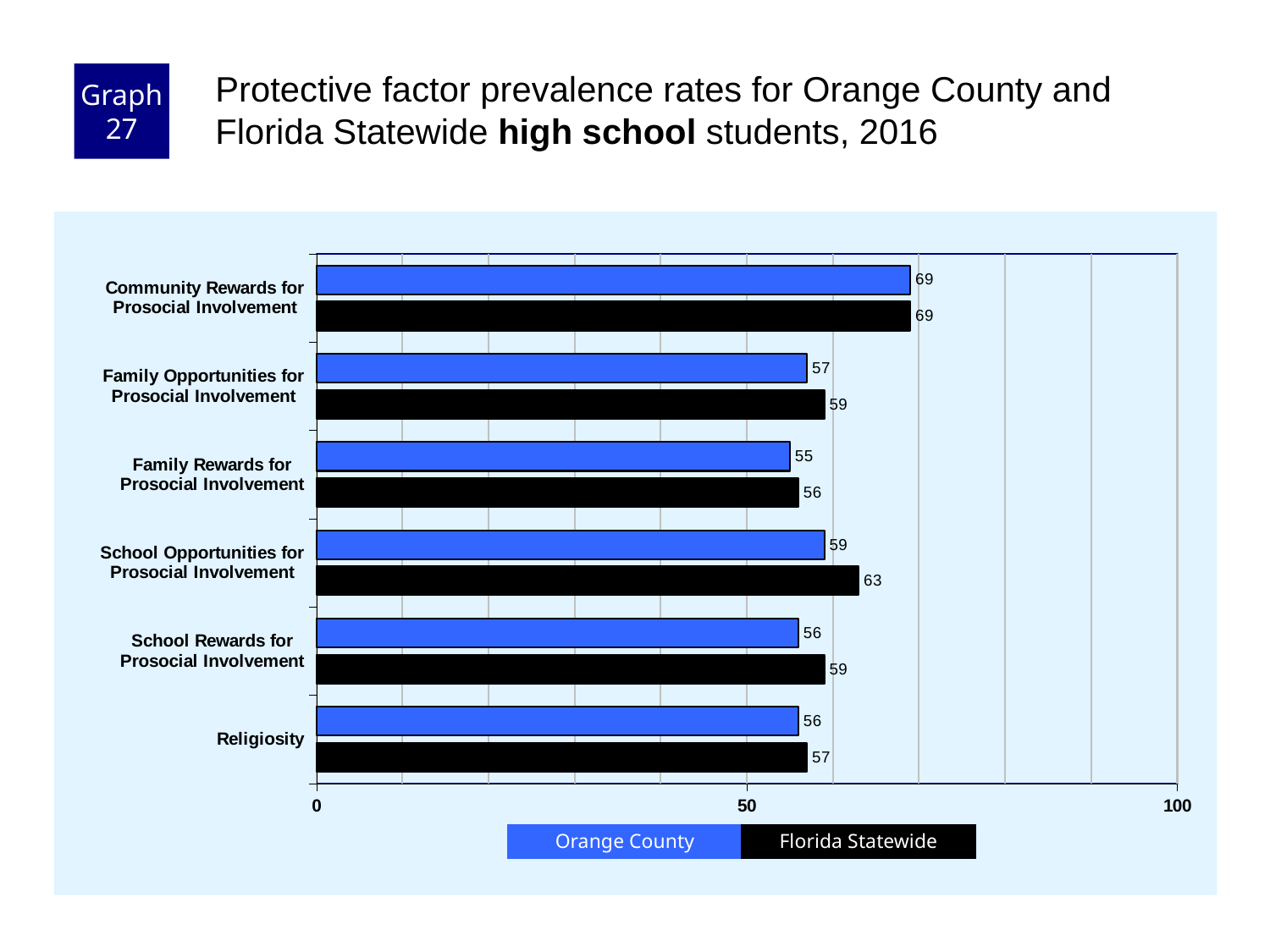
For School Rewards for Prosocial Involvement, which is larger: the Orange County value or the Florida Statewide value? Florida Statewide What is the Florida Statewide value for Religiosity? 57 How many categories are shown on the chart? 6 What is the difference between the Florida Statewide and Orange County values for School Opportunities for Prosocial Involvement? 4 How many series does the legend list? 2 What is the Orange County value for Family Rewards for Prosocial Involvement? 55 Is the Orange County value for Family Opportunities for Prosocial Involvement greater or less than 50? greater Which category has the lowest Orange County value? Family Rewards for Prosocial Involvement What is the Orange County value for Community Rewards for Prosocial Involvement? 69 Which category has the highest Orange County value? Community Rewards for Prosocial Involvement What is the Florida Statewide value for School Opportunities for Prosocial Involvement? 63 What kind of chart is shown on the slide? Bar chart